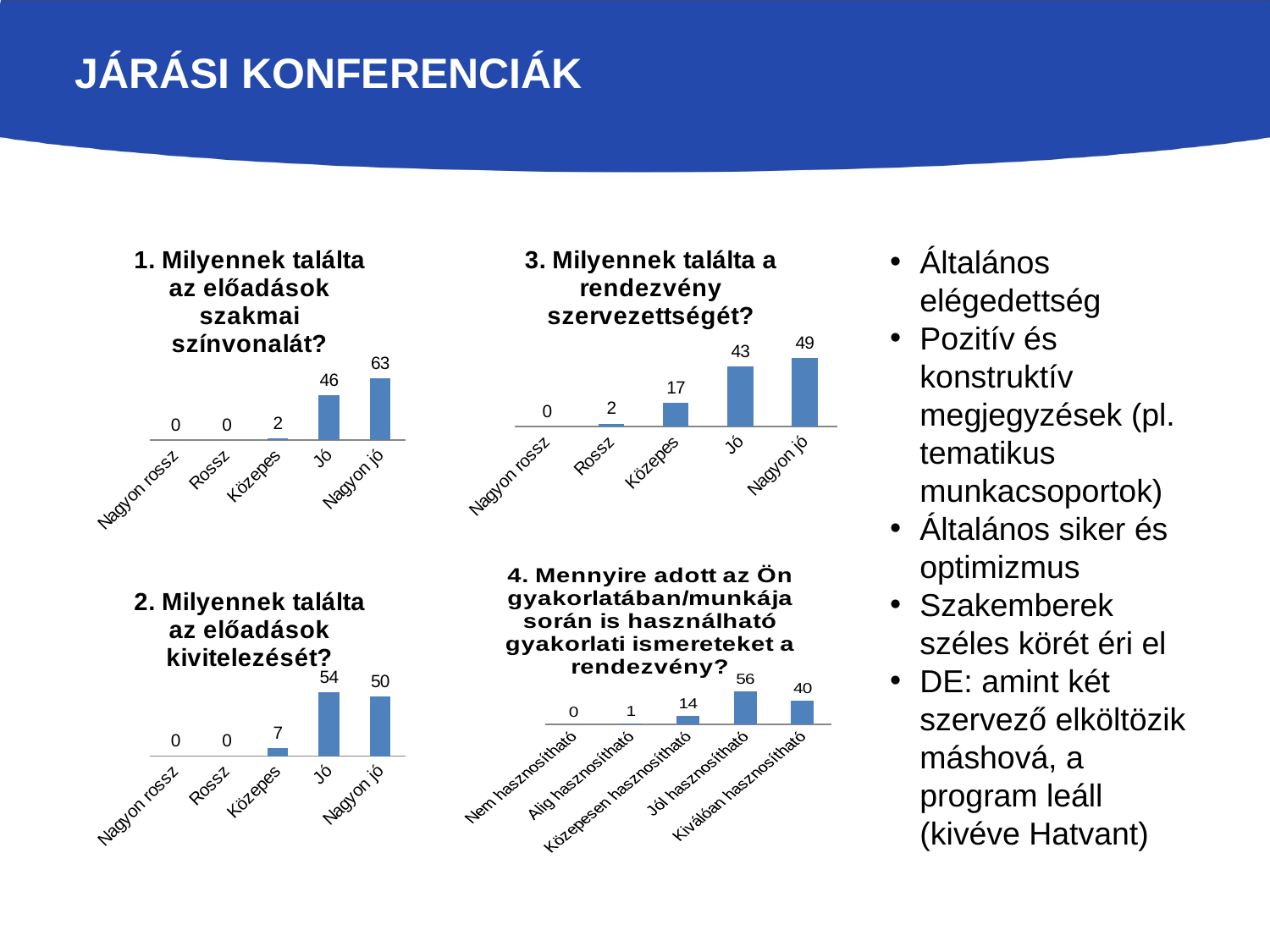
How many categories are shown in the chart titled "4. Mennyire adott az Ön gyakorlatában/munkája során is használható gyakorlati ismereteket a rendezvény?"? 5 In the chart titled "3. Milyennek találta a rendezvény szervezettségét?", what is the value for "Közepes"? 17 What type of chart is the chart titled "3. Milyennek találta a rendezvény szervezettségét?"? Bar chart In the chart titled "2. Milyennek találta az előadások kivitelezését?", what is the value for "Jó"? 54 In the chart titled "4. Mennyire adott az Ön gyakorlatában/munkája során is használható gyakorlati ismereteket a rendezvény?", what is the value for "Jól hasznosítható"? 56 In the chart titled "2. Milyennek találta az előadások kivitelezését?", what is the value for "Közepes"? 7 In the chart titled "2. Milyennek találta az előadások kivitelezését?", which is larger, the value for "Jó" or the value for "Nagyon jó"? Jó In the chart titled "1. Milyennek találta az előadások szakmai színvonalát?", what is the value for "Nagyon jó"? 63 In the chart titled "1. Milyennek találta az előadások szakmai színvonalát?", what is the difference between the values for "Nagyon jó" and "Jó"? 17 In the chart titled "1. Milyennek találta az előadások szakmai színvonalát?", which category has the highest value? Nagyon jó In the chart titled "3. Milyennek találta a rendezvény szervezettségét?", what is the difference between the values for "Nagyon jó" and "Jó"? 6 In the chart titled "4. Mennyire adott az Ön gyakorlatában/munkája során is használható gyakorlati ismereteket a rendezvény?", what is the value for "Alig hasznosítható"? 1